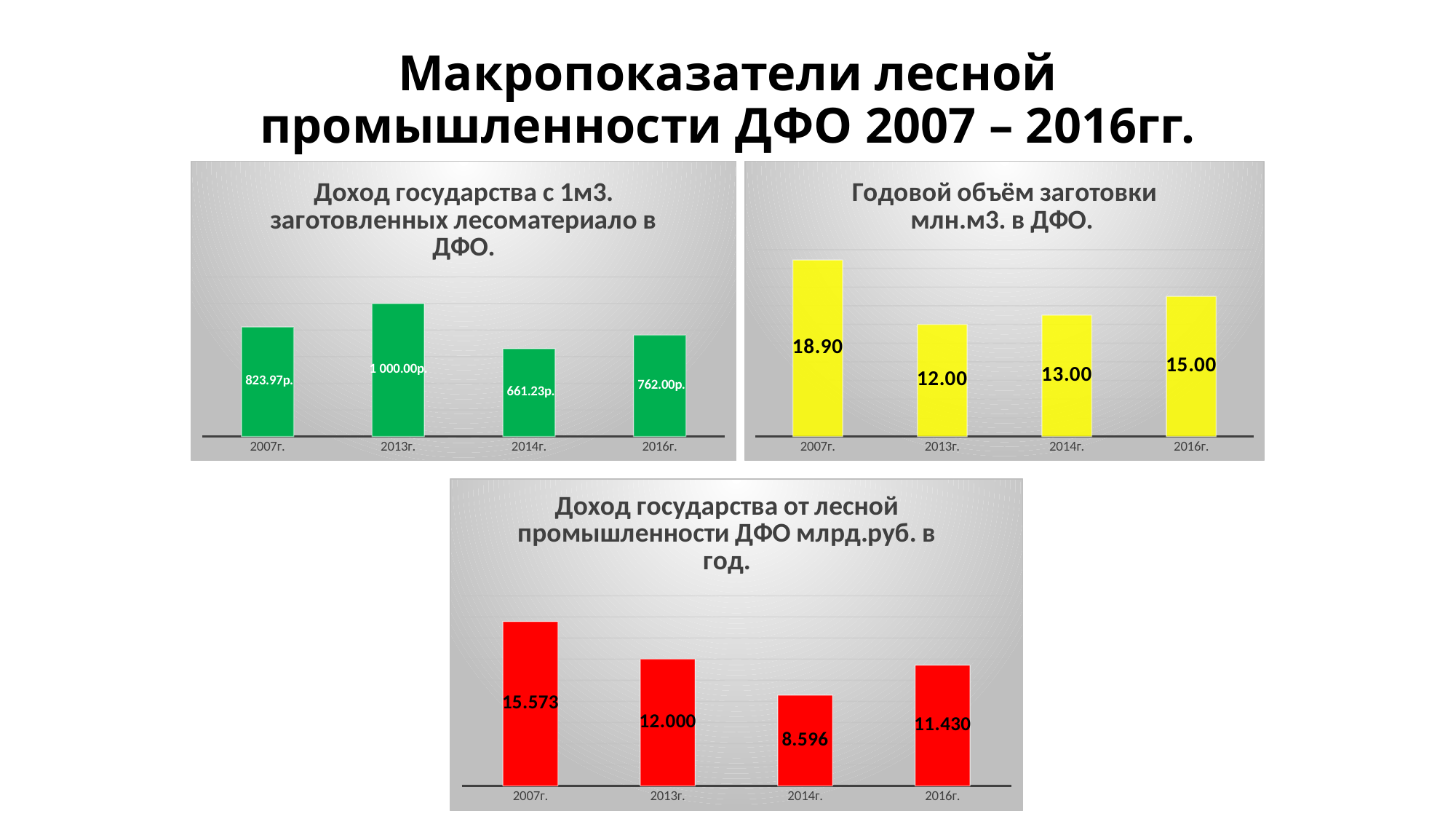
In the bottom chart (Доход государства от лесной промышленности), which year has the highest value? 2007г. What type of chart is the top-right chart (Годовой объём заготовки)? Bar chart In the top-right chart (Годовой объём заготовки), which is larger: the value for 2014г. or 2016г.? 2016г. In the top-left chart (Доход государства с 1м3), which year has the lowest value? 2014г. In the top-left chart (Доход государства с 1м3), what is the difference between the values for 2007г. and 2016г.? 61.97р. How many years are shown on the x axis of the bottom chart? 4 In the top-right chart (Годовой объём заготовки), which year has the highest value? 2007г. In the bottom chart (Доход государства от лесной промышленности), what is the value for 2014г.? 8.596 In the top-left chart (Доход государства с 1м3), what is the value for 2013г.? 1 000.00р. In the top-right chart (Годовой объём заготовки), what is the value for 2007г.? 18.90 In the top-right chart (Годовой объём заготовки), what is the difference between the values for 2007г. and 2013г.? 6.90 In the bottom chart (Доход государства от лесной промышленности), what is the difference between the values for 2013г. and 2016г.? 0.570